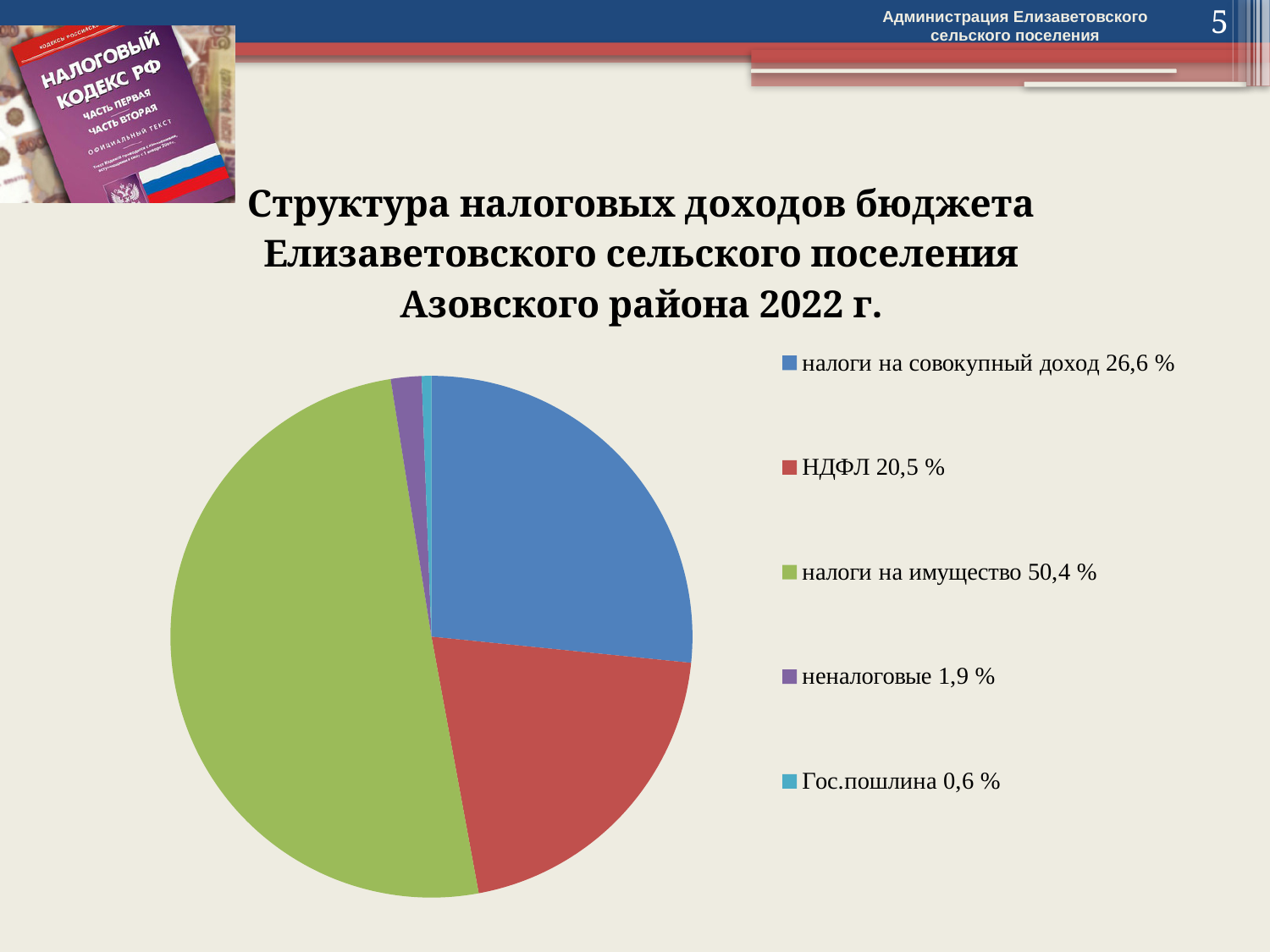
What share of the pie does "налоги на имущество" have? 50,4 % What share of the pie does "Гос.пошлина" have? 0,6 % How many slices does the pie chart have? 5 What share of the pie does "неналоговые" have? 1,9 % What share of the pie does "НДФЛ" have? 20,5 % Which category has the smallest slice of the pie? Гос.пошлина What is the difference in percentage points between "налоги на совокупный доход" and "НДФЛ"? 6,1 Which category has the largest slice of the pie? налоги на имущество Which is larger, the share for "НДФЛ" or the share for "неналоговые"? НДФЛ What share of the pie does "налоги на совокупный доход" have? 26,6 % What kind of chart is shown on the slide? pie chart What colour is the slice for "налоги на имущество"? green